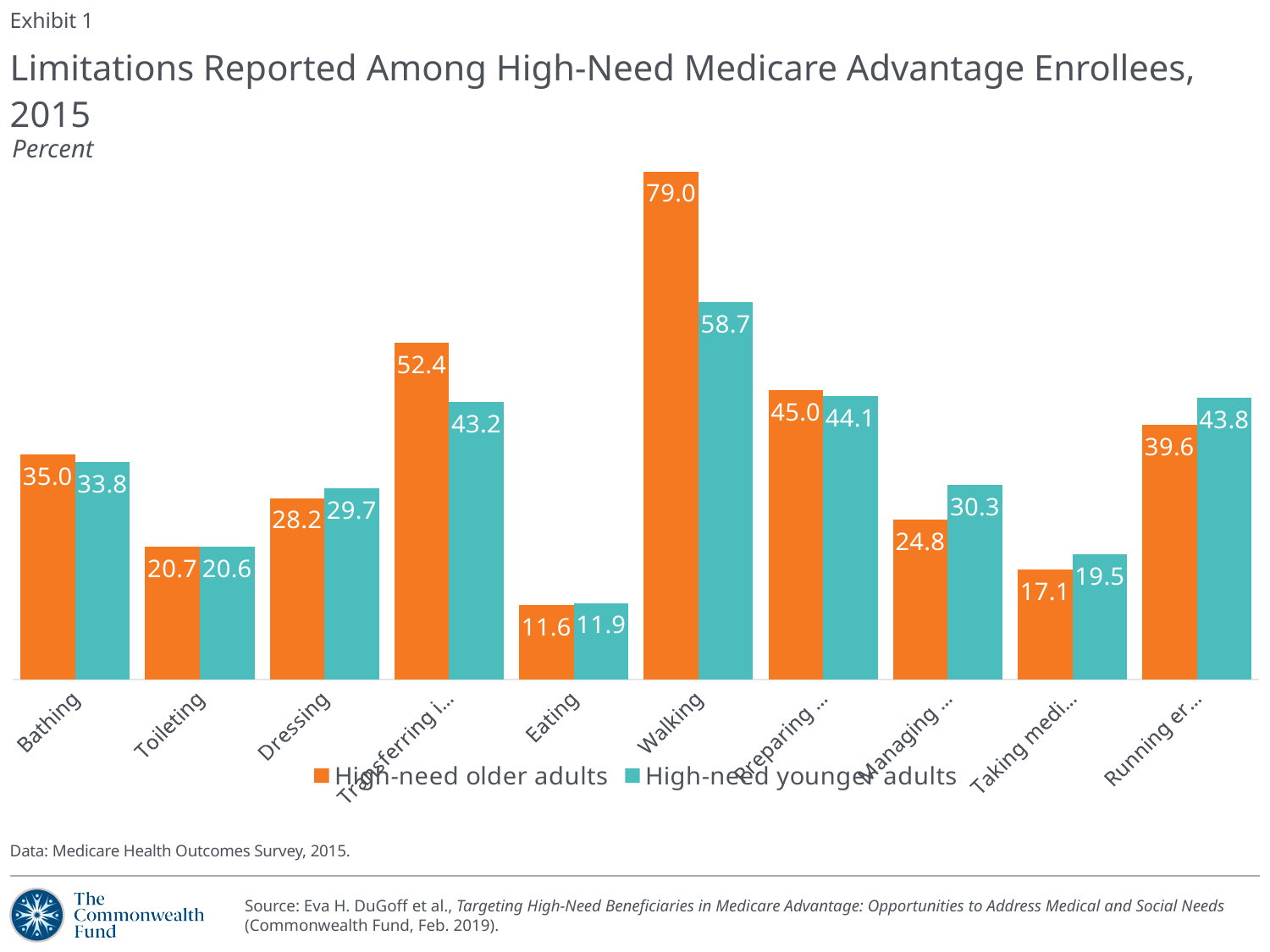
What is the value for high-need older adults for Walking? 79.0 Which category has the highest value for high-need older adults? Walking How many series does the legend list? 2 Which category has the lowest value for high-need younger adults? Eating What is the value for high-need older adults for Dressing? 28.2 For Dressing, which group has the larger value: high-need older adults or high-need younger adults? High-need younger adults What is the difference between high-need older adults and high-need younger adults for Walking? 20.3 What kind of chart is shown on the slide? Bar chart What is the value for high-need younger adults for Eating? 11.9 Which colour represents high-need older adults in the legend? Orange How many categories are shown on the x axis? 10 What is the value for high-need younger adults for Bathing? 33.8